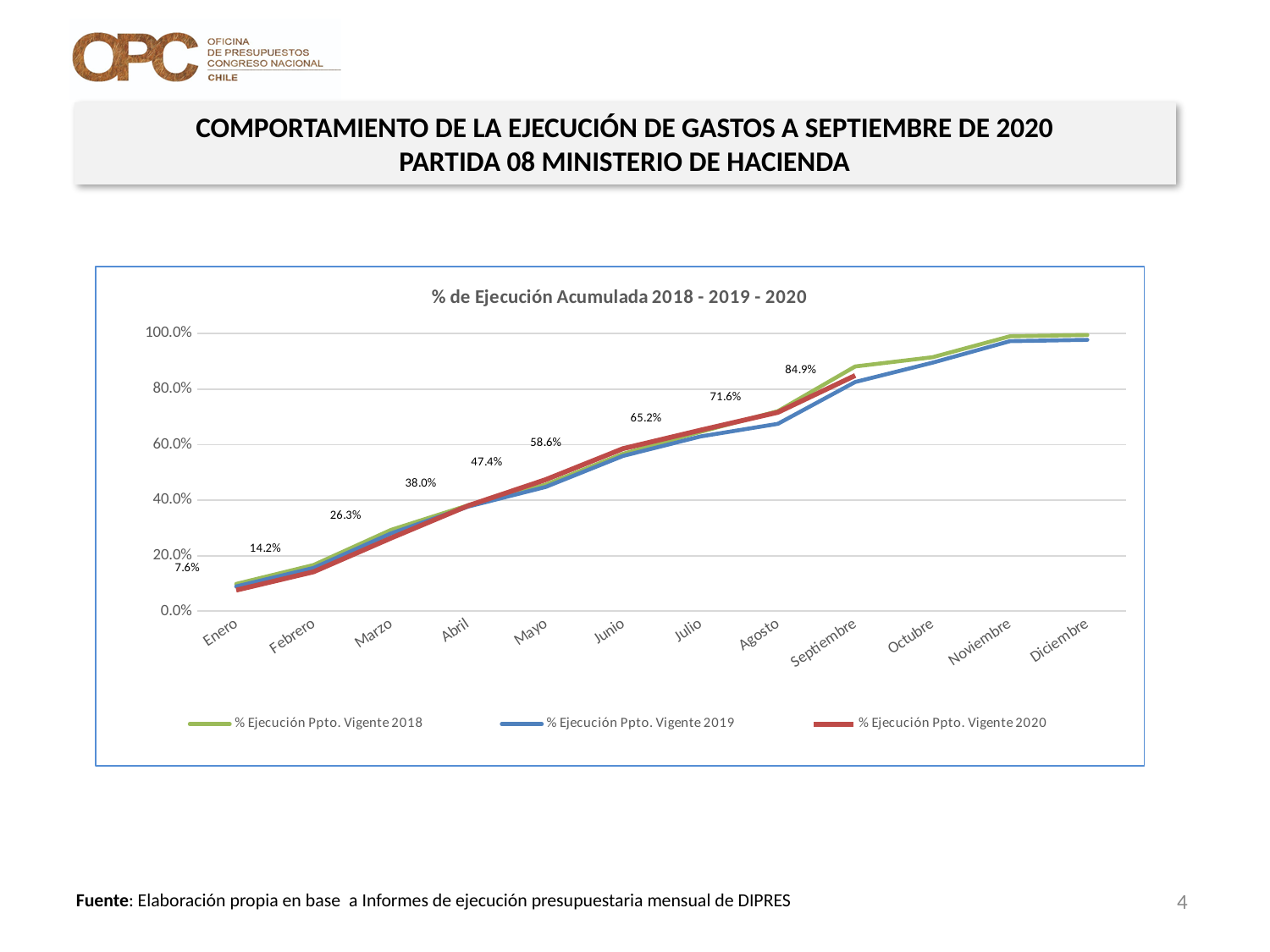
What type of chart is shown on the slide? line chart What is the labelled value for % Ejecución Ppto. Vigente 2020 in Junio? 58.6% What is the labelled value for % Ejecución Ppto. Vigente 2020 in Septiembre? 84.9% What is the difference between the 2020 labelled values for Febrero (14.2%) and Enero (7.6%)? 6.6% How many months are shown along the x axis? 12 Do the values of the % Ejecución Ppto. Vigente 2020 series rise or fall from Enero to Septiembre? rise What is the labelled value for % Ejecución Ppto. Vigente 2020 in Abril? 38.0% What is the title of the chart? % de Ejecución Acumulada 2018 - 2019 - 2020 Is the value for % Ejecución Ppto. Vigente 2018 in Diciembre greater or less than 80.0%? greater How many series does the legend list? 3 What is the labelled value for % Ejecución Ppto. Vigente 2020 in Enero? 7.6% What is the difference between the 2020 labelled values for Septiembre (84.9%) and Agosto (71.6%)? 13.3%